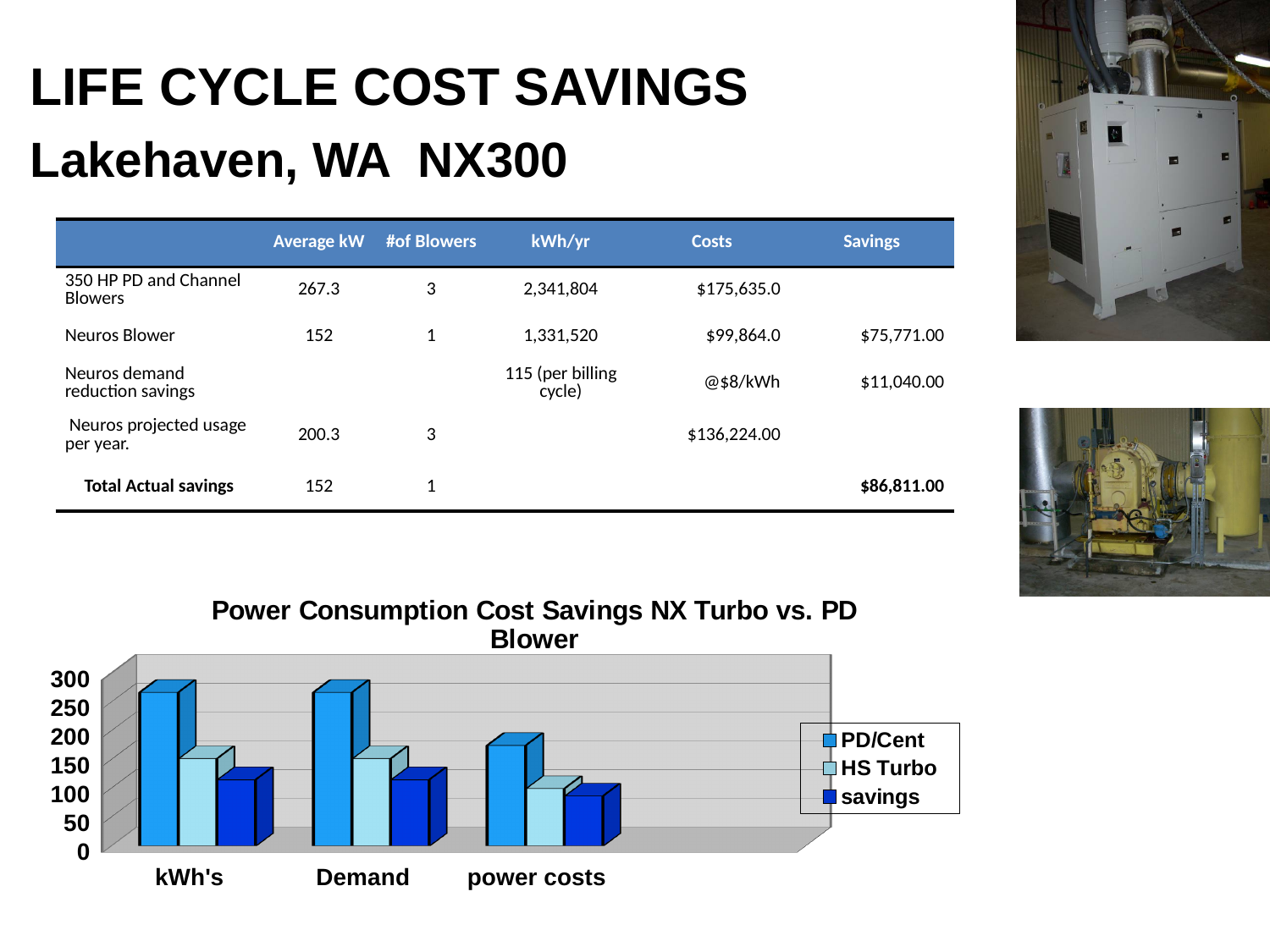
Is the savings value for Demand greater or less than 150? less What type of chart is shown on the slide? bar chart Which series has the highest value in the kWh's category? PD/Cent In which category is the PD/Cent value lowest? power costs What is the title of the chart on the slide? Power Consumption Cost Savings NX Turbo vs. PD Blower Is the PD/Cent value for kWh's greater or less than 200? greater Which series has the lowest value in the power costs category? savings How many series does the chart's legend list? 3 How many categories are shown on the x axis of the chart? 3 Which series does the legend list first? PD/Cent Which is larger, the PD/Cent value for Demand or the PD/Cent value for power costs? Demand Is the HS Turbo value for power costs greater or less than 150? less